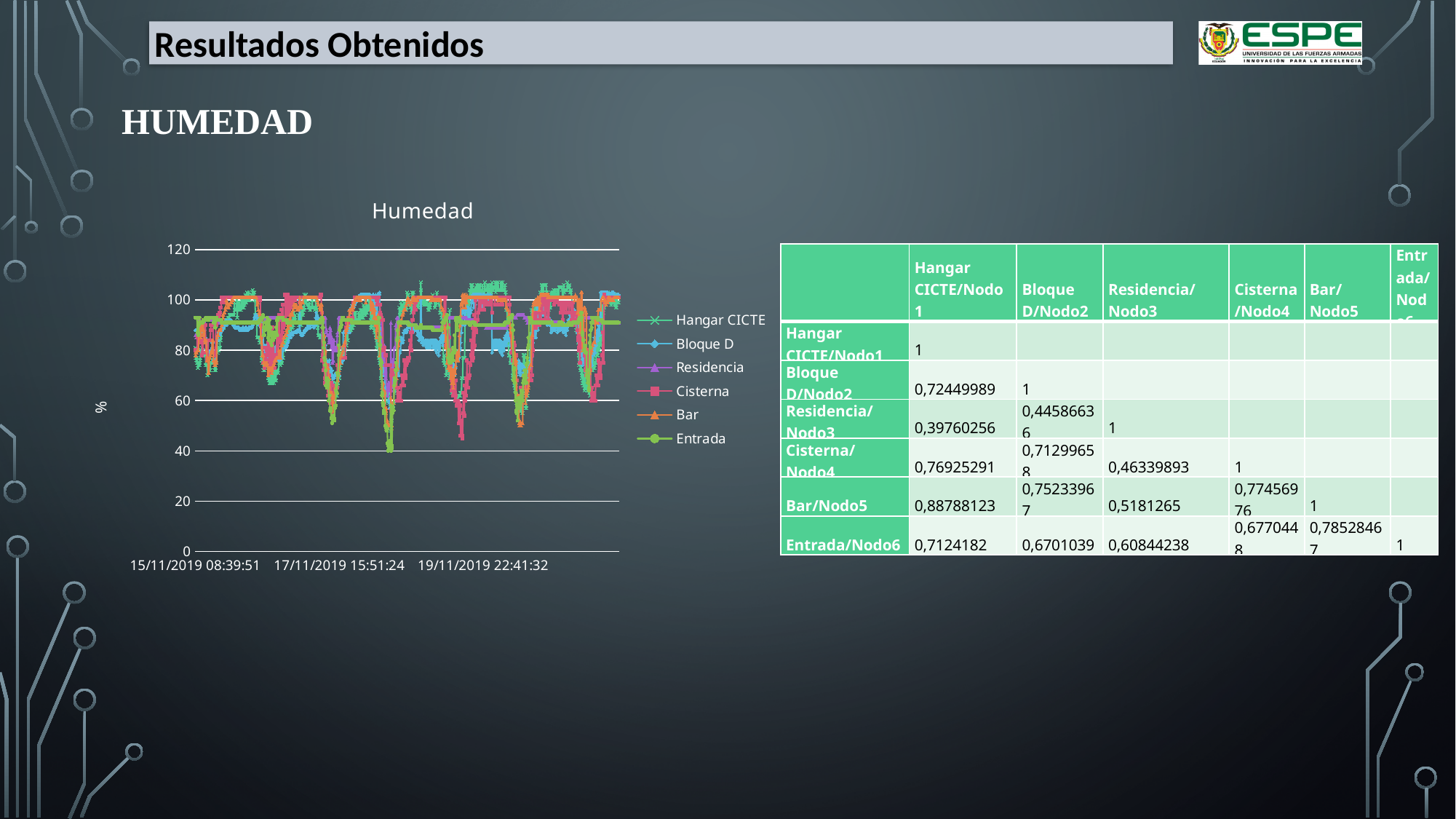
Is the lowest value reached by the Cisterna series greater or less than 60? less Is the highest value reached by the Entrada series greater or less than 80? greater What kind of chart is shown on the slide? line chart What is the first date label shown on the chart's x axis? 15/11/2019 08:39:51 How many date labels are shown on the chart's x axis? 3 Is the lowest value reached by the Entrada series greater or less than 60? less What is the title of the chart? Humedad Which series is listed last in the chart legend? Entrada What is the label on the chart's y axis? % What is the highest value shown on the chart's y axis? 120 How many series does the chart legend list? 6